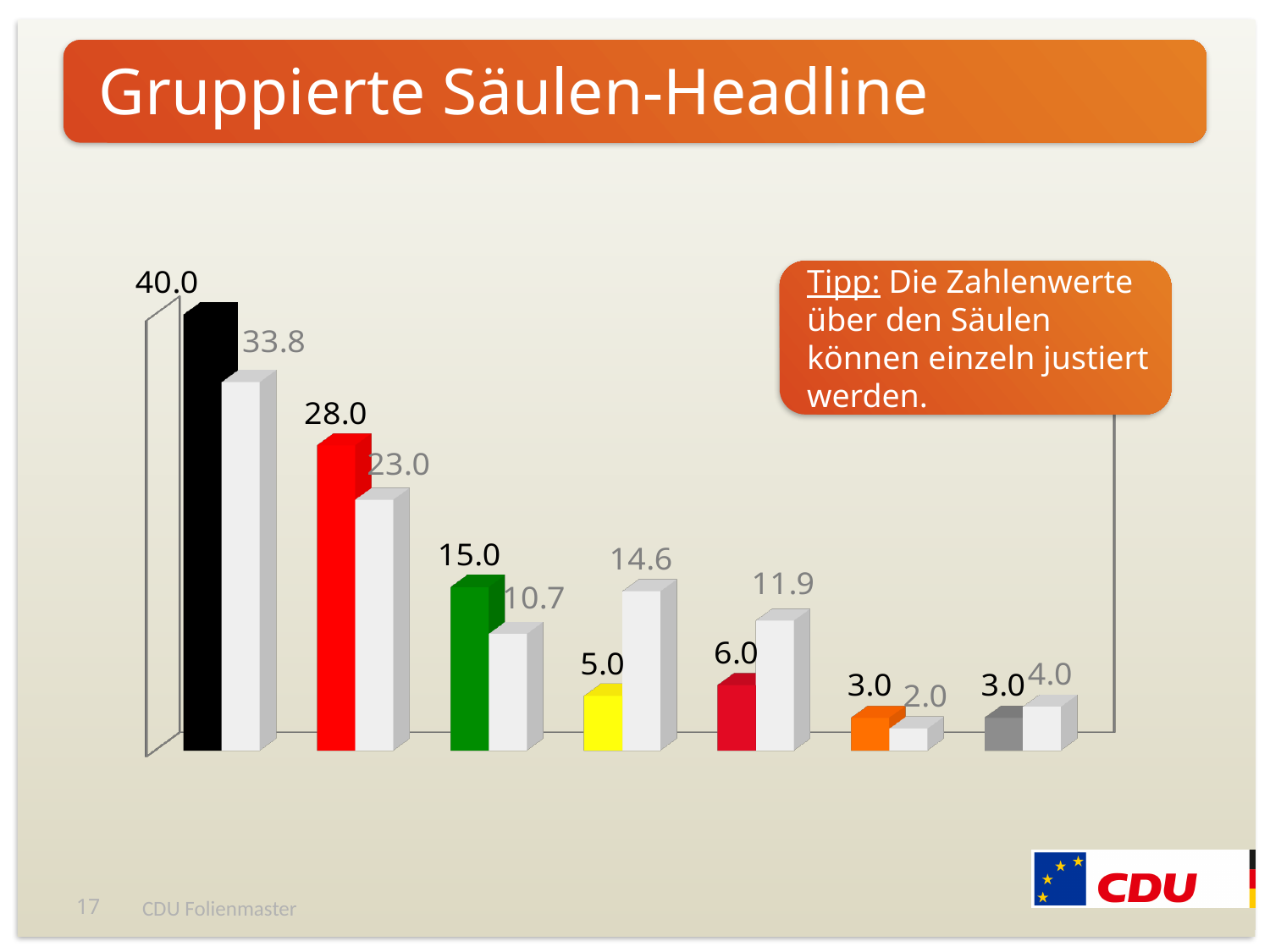
What is the value shown above the orange bar? 3.0 What is the value of the light gray bar in the first group, next to the black bar? 33.8 Which coloured bar has the highest value in the chart? the black bar (40.0) How many groups of bars does the chart contain? 7 What is the title of the slide containing the chart? Gruppierte Säulen-Headline What is the value shown above the black bar in the first group? 40.0 What is the value shown above the red bar in the second group? 28.0 In the fourth group, which is larger: the yellow bar or the light gray bar next to it? the light gray bar (14.6) Which bar has the lowest value in the chart? the light gray bar next to the orange bar (2.0) What kind of chart is shown on the slide? bar chart What is the difference between the black bar (40.0) and the light gray bar next to it (33.8)? 6.2 What is the value of the light gray bar in the fourth group, next to the yellow bar? 14.6